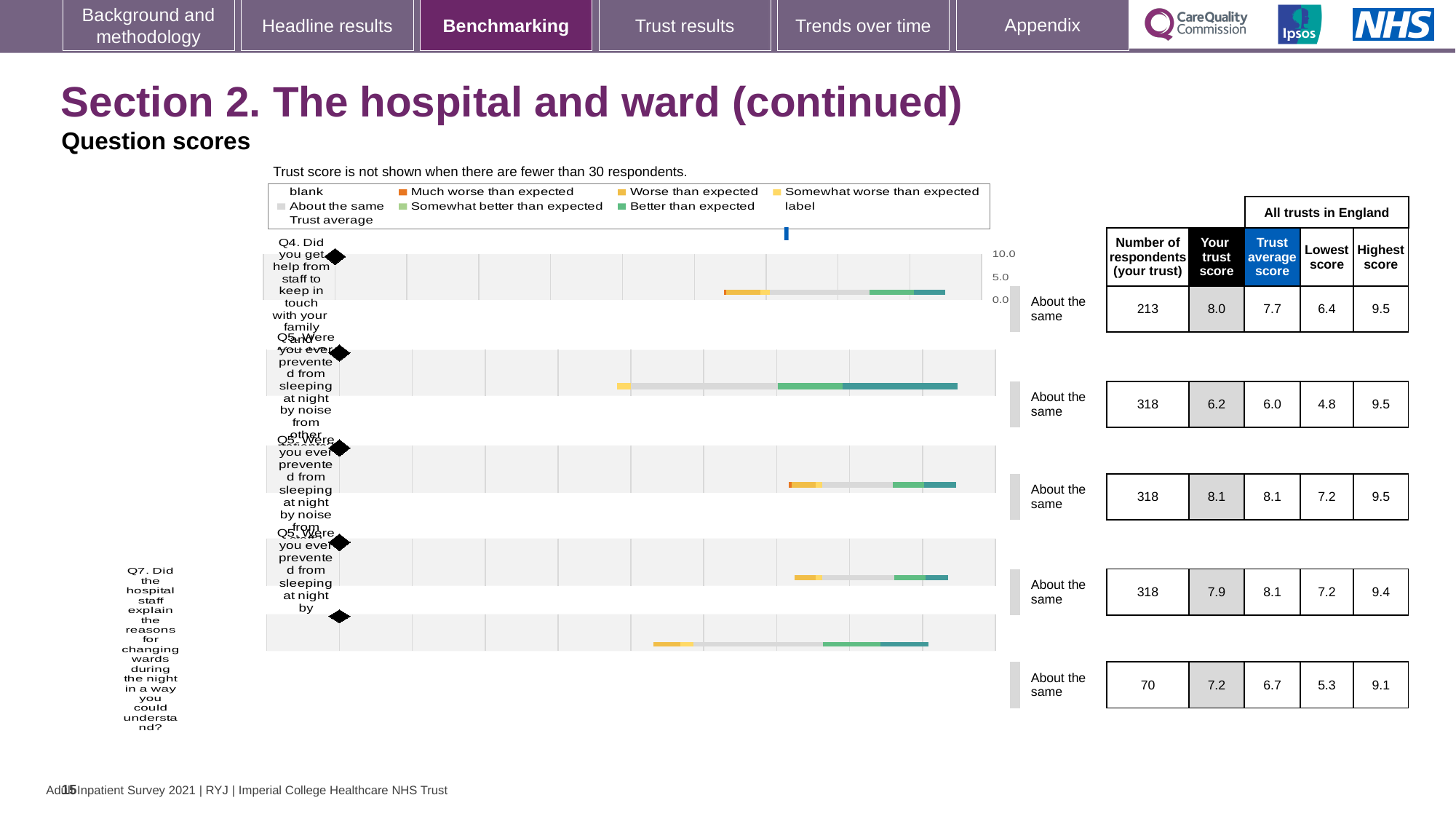
For Q4, which is larger: the 'Your trust score' or the 'Trust average score'? Your trust score How many question rows (bars) are shown in the benchmarking chart? 5 What is the 'Your trust score' value for Q7 (explaining reasons for changing wards during the night)? 7.2 For Q7, what is the difference between the 'Your trust score' (7.2) and the 'Trust average score' (6.7)? 0.5 What is the highest 'Your trust score' value shown in the table on this slide? 8.1 How many respondents (your trust) are shown for Q7? 70 What is the 'Your trust score' value for Q4 (help from staff to keep in touch with family)? 8.0 How many respondents (your trust) are shown for Q4? 213 What benchmark category is shown next to the Q4 bar? About the same What kind of chart is used to show the question scores on this slide? bar chart What is the lowest 'Your trust score' value shown in the table on this slide? 6.2